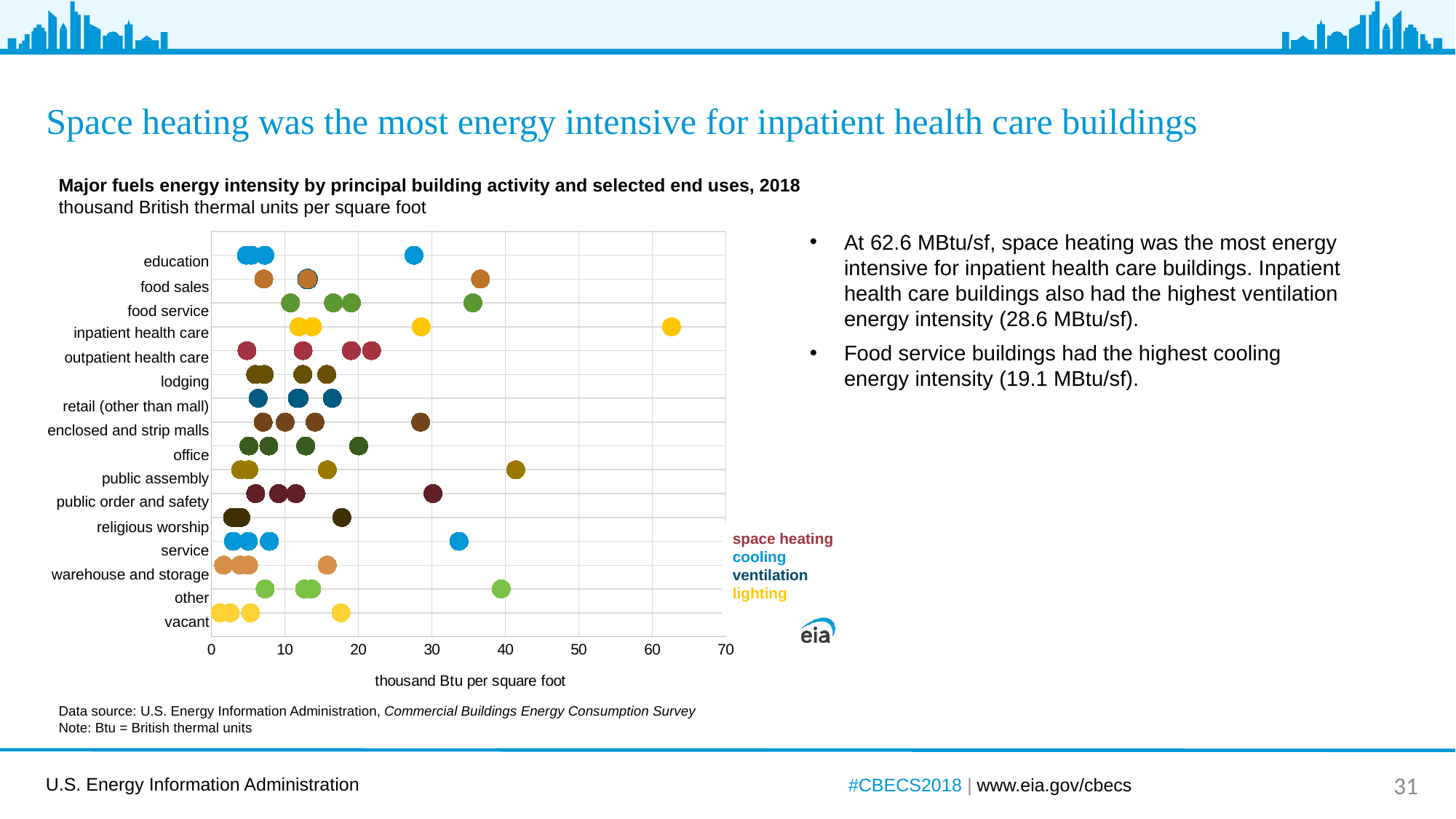
Is the space heating value for inpatient health care greater or less than 60? greater What kind of chart is shown on the slide? dot plot (scatter chart) Which building activity has the highest space heating energy intensity in the chart? inpatient health care What is the space heating energy intensity for inpatient health care buildings, as stated on the slide? 62.6 MBtu/sf Is the space heating value for education greater or less than 30? less Which building activity had the highest cooling energy intensity? food service What is the ventilation energy intensity for inpatient health care buildings, as stated on the slide? 28.6 MBtu/sf Is the space heating value for vacant buildings greater or less than 20? less What unit is shown on the x axis of the chart? thousand Btu per square foot How many end-use series does the chart legend list? 4 How many building activity categories are listed on the y axis of the chart? 16